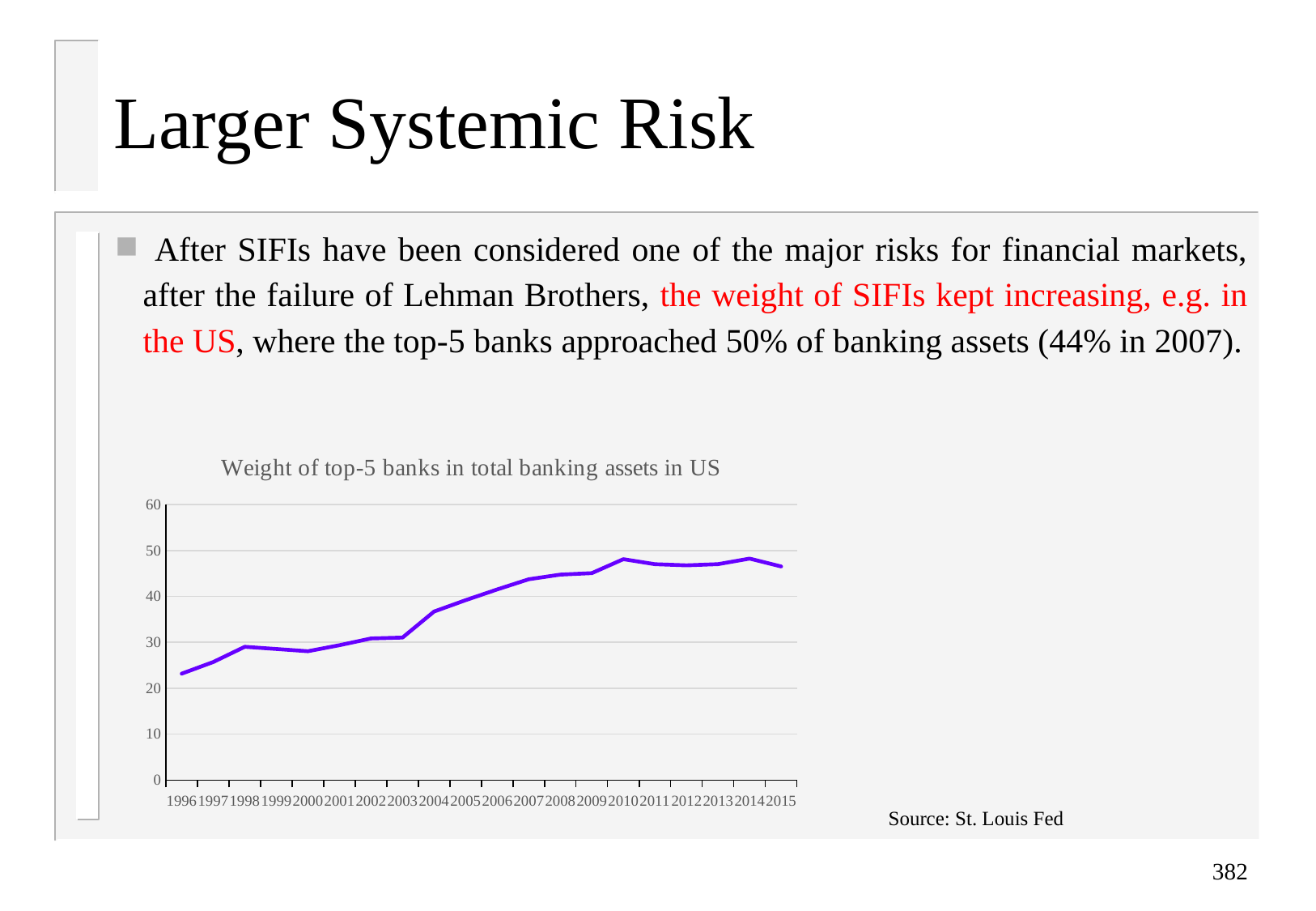
How many years are plotted on the x axis of the chart? 20 What is the title of the chart? Weight of top-5 banks in total banking assets in US Overall, do the values rise or fall from 1996 to 2015? rise Is the value for 1996 greater or less than 30? less Is the value for 2007 greater or less than 40? greater Is the value for 2010 greater or less than 50? less What kind of chart is shown on the slide? line chart Which is larger, the value for 2010 or the value for 1996? 2010 What source is cited for the chart? St. Louis Fed Which year has the lowest value in the chart? 1996